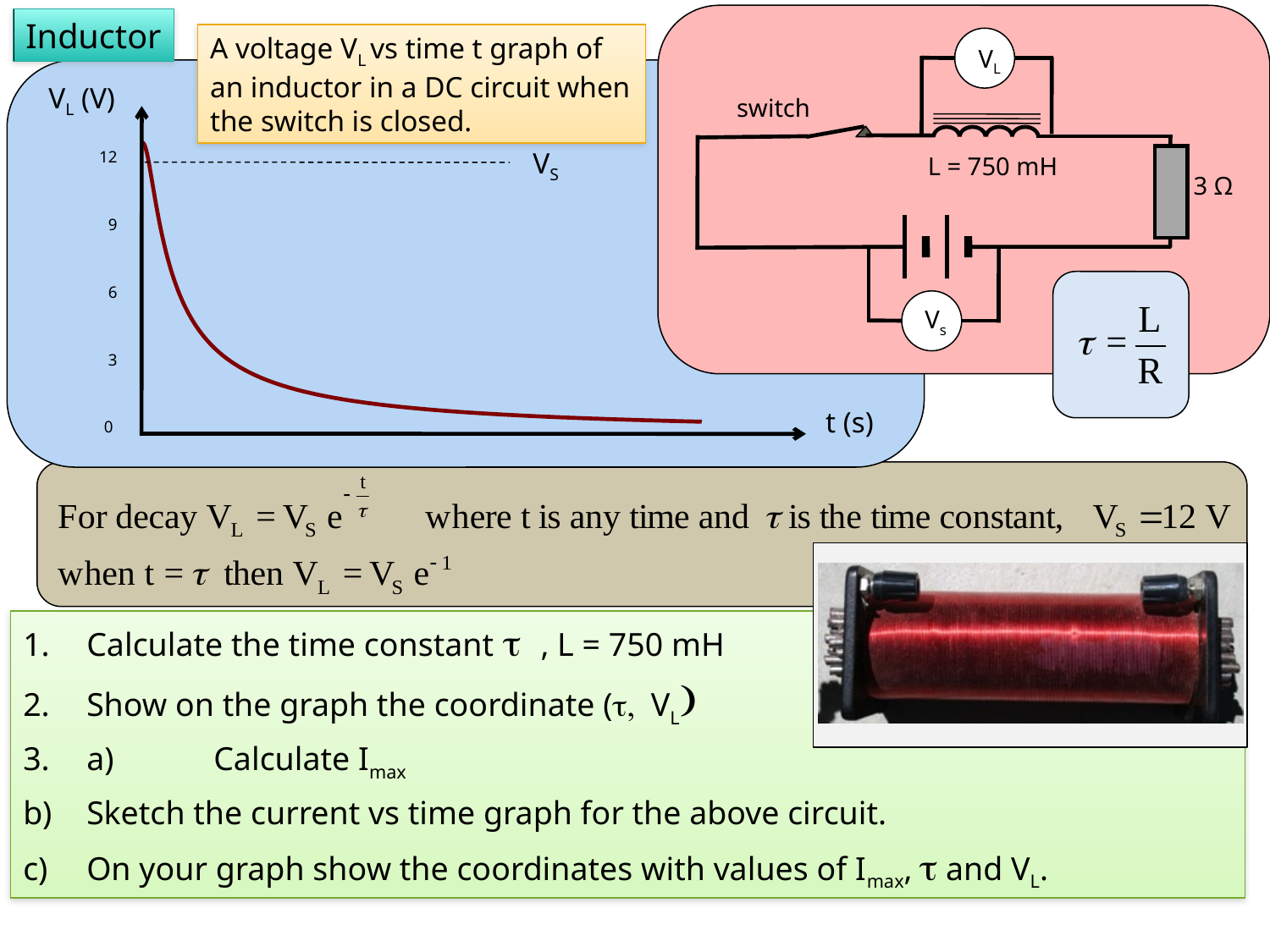
What is the lowest numbered tick on the vertical axis of the graph? 0 What value does the dashed horizontal line labelled V_S correspond to on the vertical axis? 12 What is the highest numbered tick on the vertical axis of the graph? 12 Does the plotted voltage V_L rise or fall as time t increases? fall Is the value of V_L at the right-hand end of the curve greater or less than 3? less What is the label of the vertical axis of the graph? V_L (V) Is the value of V_L at the start of the curve (t = 0) greater or less than 9? greater What kind of chart is the voltage vs time graph on the slide? line chart What is the label of the horizontal axis of the graph? t (s) How many numbered tick marks are shown on the vertical axis of the graph? 5 Is the value of V_L at the midpoint of the time axis greater or less than 6? less